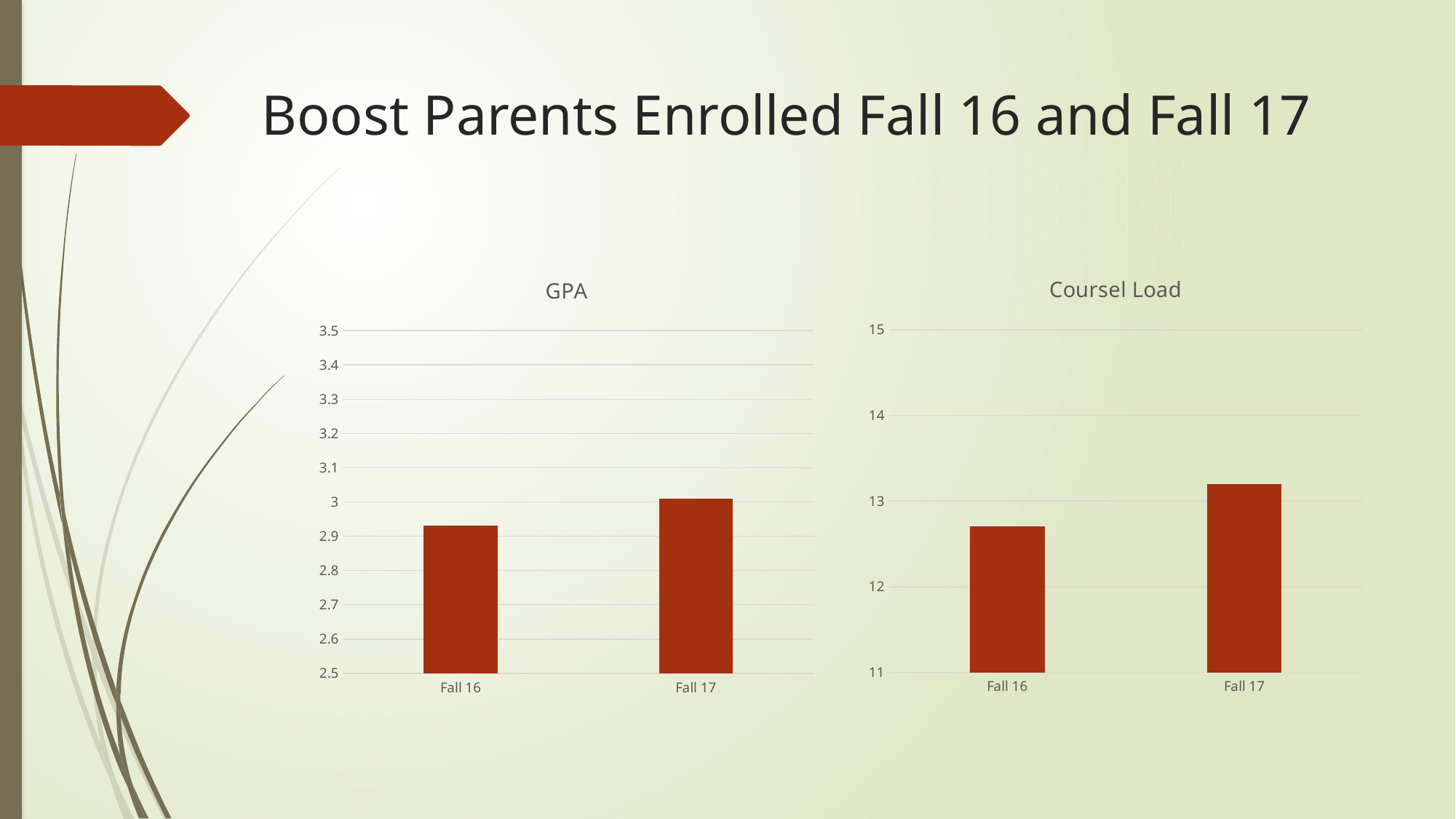
In the GPA chart, is the value for Fall 16 greater or less than 3? less How many categories are shown in the Coursel Load chart? 2 In the GPA chart, is the value for Fall 16 greater or less than 2.8? greater In the Coursel Load chart, do the values rise or fall from Fall 16 to Fall 17? rise In the Coursel Load chart, is the value for Fall 16 greater or less than 13? less In the GPA chart, which category has the higher bar, Fall 16 or Fall 17? Fall 17 What kind of chart is the GPA chart? bar chart In the GPA chart, which category has the lowest value? Fall 16 In the Coursel Load chart, which category has the highest value? Fall 17